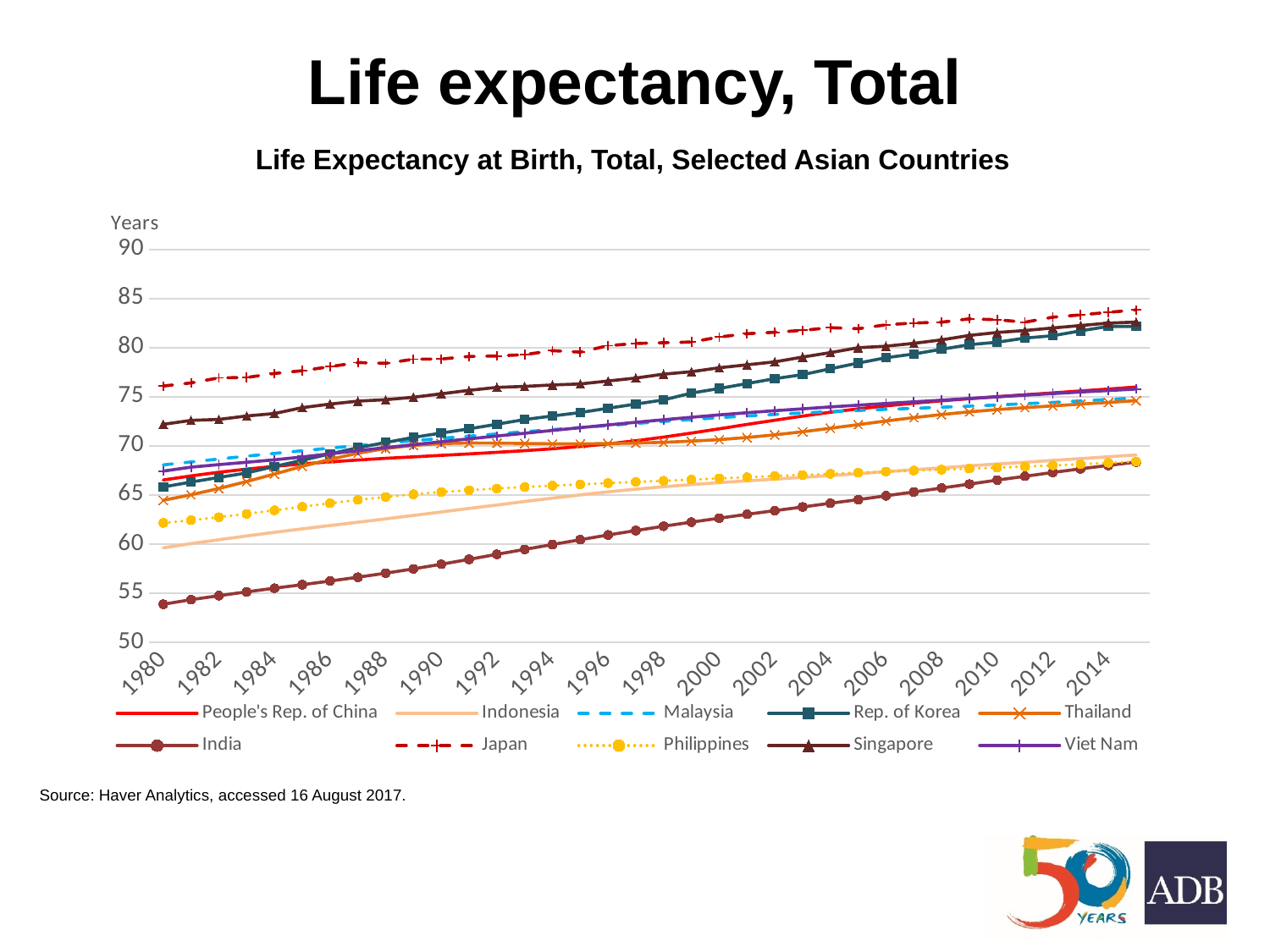
Is the value for India in 1980 greater or less than 55? less Which is larger in 2014, the value for Rep. of Korea or the value for Philippines? Rep. of Korea Which country has the highest life expectancy in 2014? Japan What kind of chart is shown on the slide? line chart How many series does the legend list? 10 Is the value for Japan in 1980 greater or less than 75? greater Does the life expectancy for India rise or fall from 1980 to 2014? rise Which country has the lowest life expectancy in 1980? India What unit is shown on the vertical axis? Years Is the value for Singapore in 2014 greater or less than 80? greater